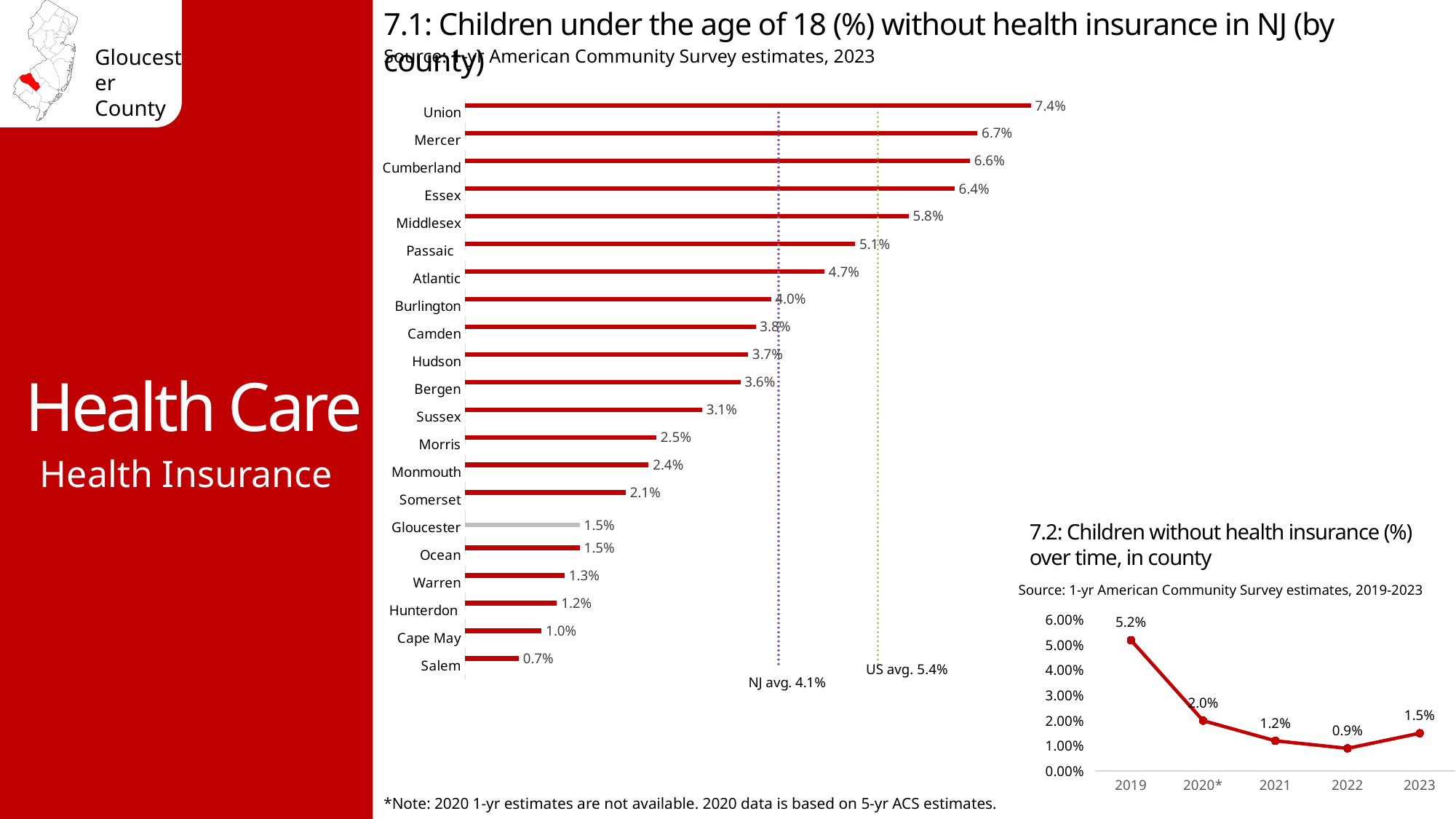
In chart 7.2, which year has the highest value? 2019 In chart 7.1, which county has the highest percentage of children without health insurance? Union In chart 7.1, how many counties are shown? 21 What kind of chart is chart 7.1? bar chart In chart 7.1, which county has the lowest percentage of children without health insurance? Salem In chart 7.2, what is the difference between the 2019 and 2023 values? 3.7% In chart 7.1, what is the difference between the values for Union and Salem? 6.7% In chart 7.2 (children without health insurance over time), what is the value for 2022? 0.9% In chart 7.2, how many data points are plotted? 5 In chart 7.1 (children under 18 without health insurance by county), what is the value for Gloucester? 1.5% In chart 7.1, what is the NJ average shown by the dotted line? 4.1% In chart 7.1, which county has a larger value, Camden or Burlington? Burlington